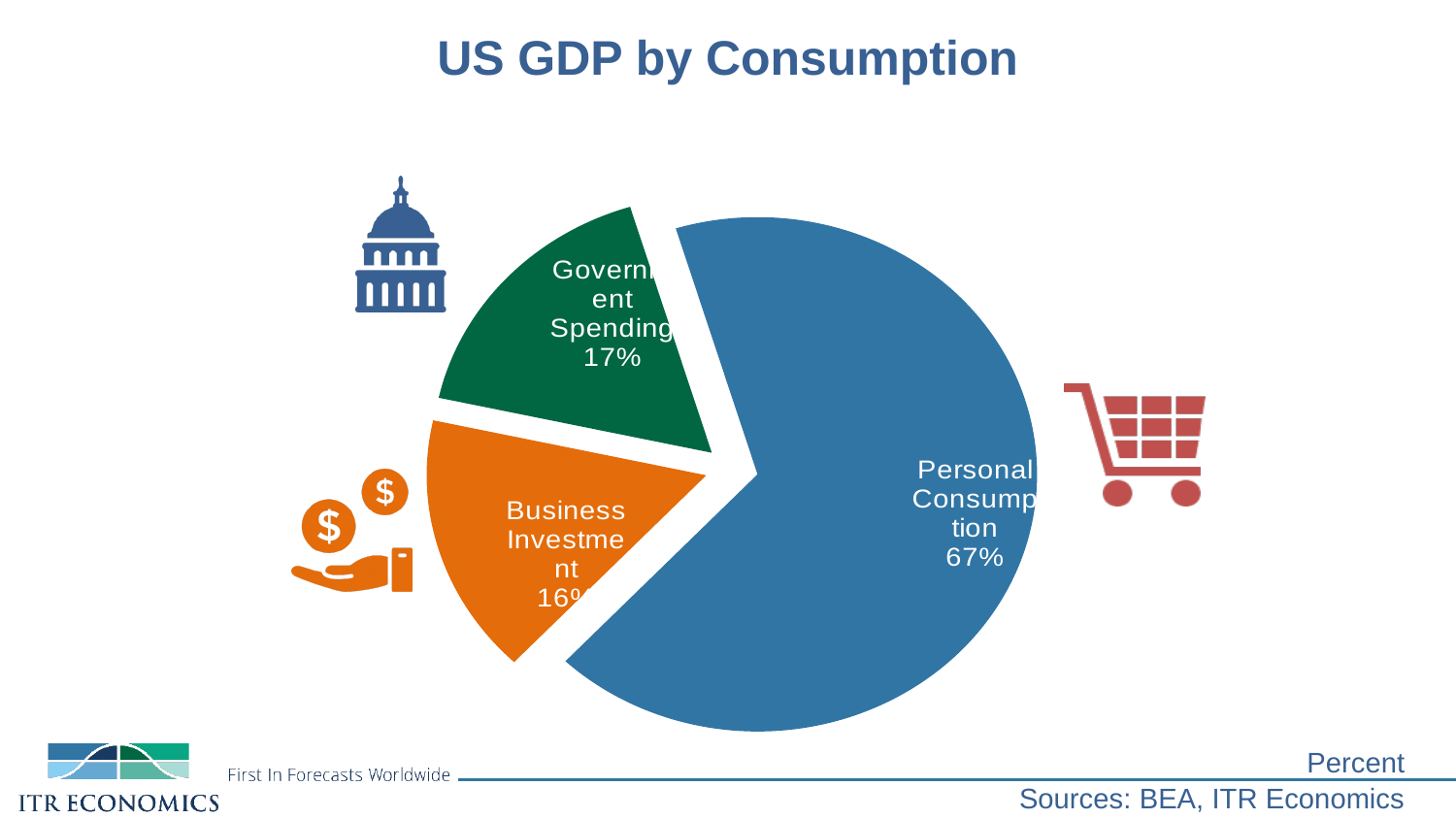
What is the difference in percentage points between Personal Consumption and Government Spending? 50 What kind of chart is shown on the slide? pie chart Which is larger, Government Spending or Business Investment? Government Spending How many slices does the pie chart have? 3 What share of US GDP is Personal Consumption? 67% What is the combined share of Government Spending and Business Investment? 33% Which category has the smallest share of the pie? Business Investment What is the title of the chart? US GDP by Consumption What colour is the Personal Consumption slice? blue Which category has the largest share of the pie? Personal Consumption What share of US GDP is Government Spending? 17% What share of US GDP is Business Investment? 16%